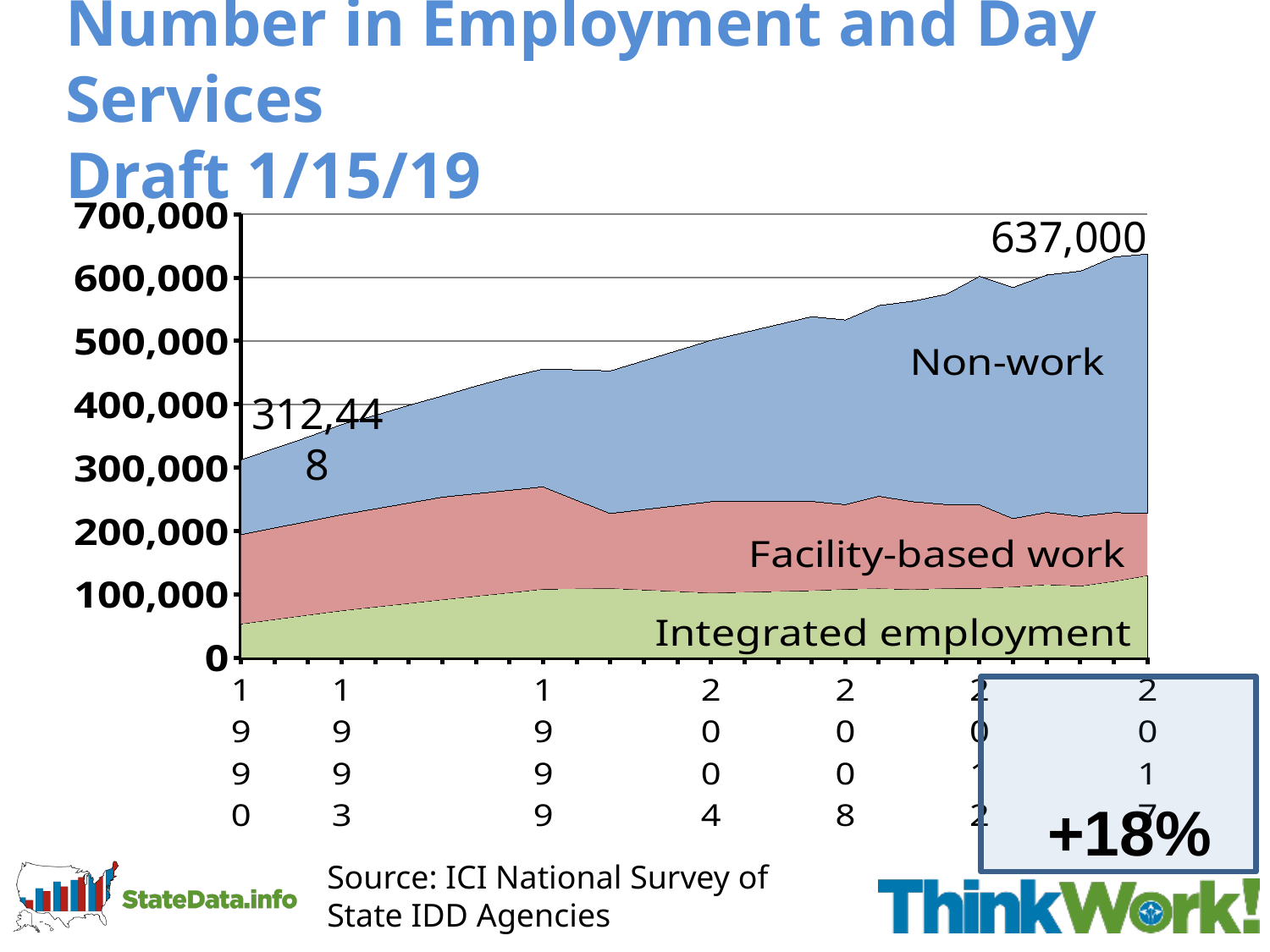
What kind of chart is shown on the slide? Stacked area chart By how much did the labelled total grow from 312,448 in 1990 to 637,000 in 2017? 324,552 Does the overall total rise or fall from 1990 to 2017? Rises Which is larger, the labelled total in 1990 or the labelled total in 2017? 2017 What percentage change is shown in the callout box at the bottom right of the chart? +18% Which series is plotted at the top of the stack? Non-work Which series is plotted at the bottom of the stack? Integrated employment What is the total number in employment and day services labelled at the start of the series in 1990? 312,448 Is the value for Integrated employment in 2017 greater or less than 100,000? greater Is the overall total in 1999 greater or less than 500,000? less What is the total number labelled at the end of the series in 2017? 637,000 How many series are stacked in the chart? 3